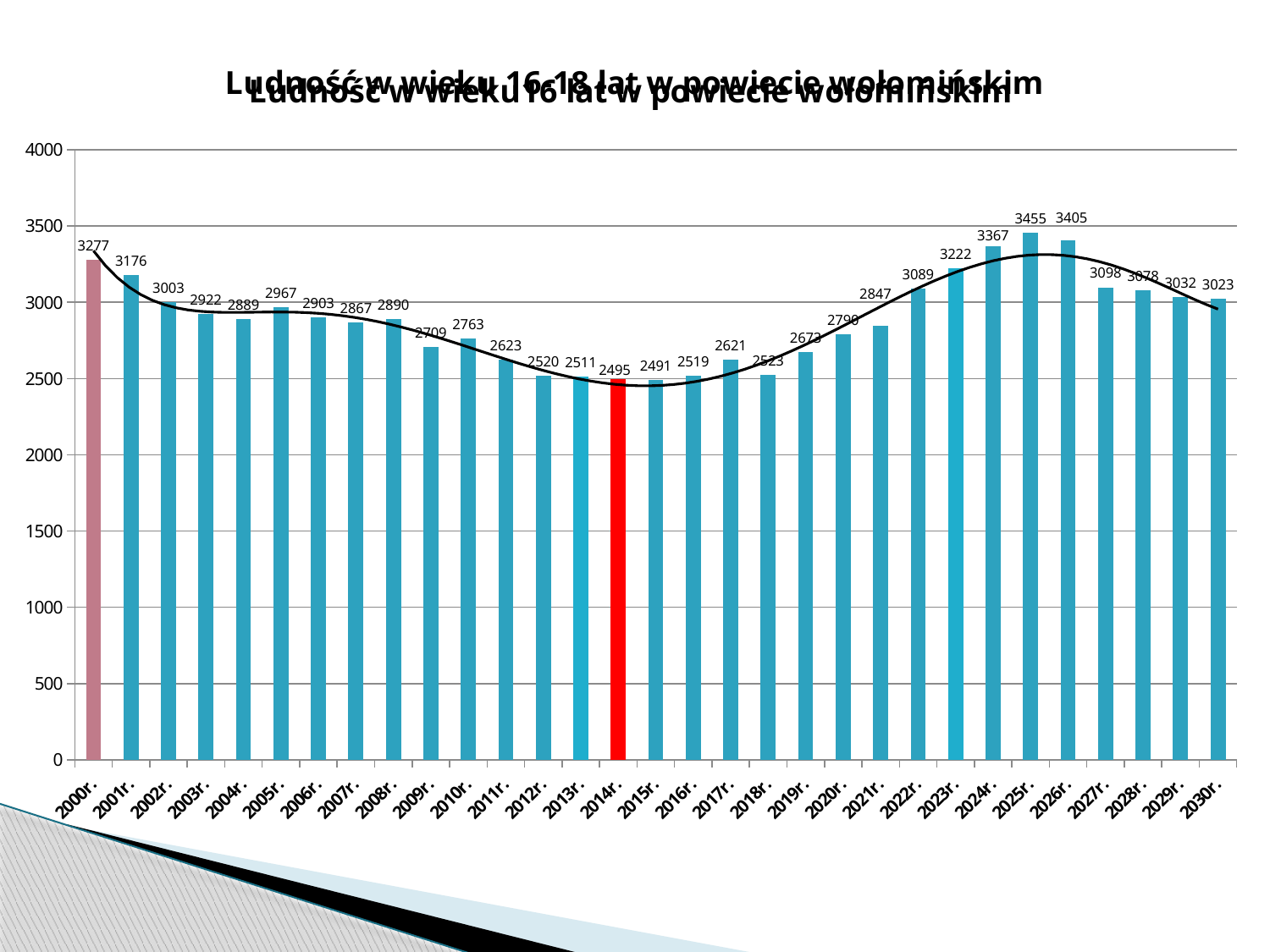
What is the value for 2000r.? 3277 Which year has the highest value? 2025r. What is the value for 2014r.? 2495 What is the value for 2025r.? 3455 Which is larger, the value for 2001r. or the value for 2026r.? 2026r. Which year has the lowest value? 2015r. How many years are shown on the x axis? 31 What is the value for 2030r.? 3023 Which bar is coloured red? 2014r. Is the value for 2012r. greater or less than 3000? less What is the difference between the values for 2025r. and 2015r.? 964 What kind of chart is shown on the slide? bar chart